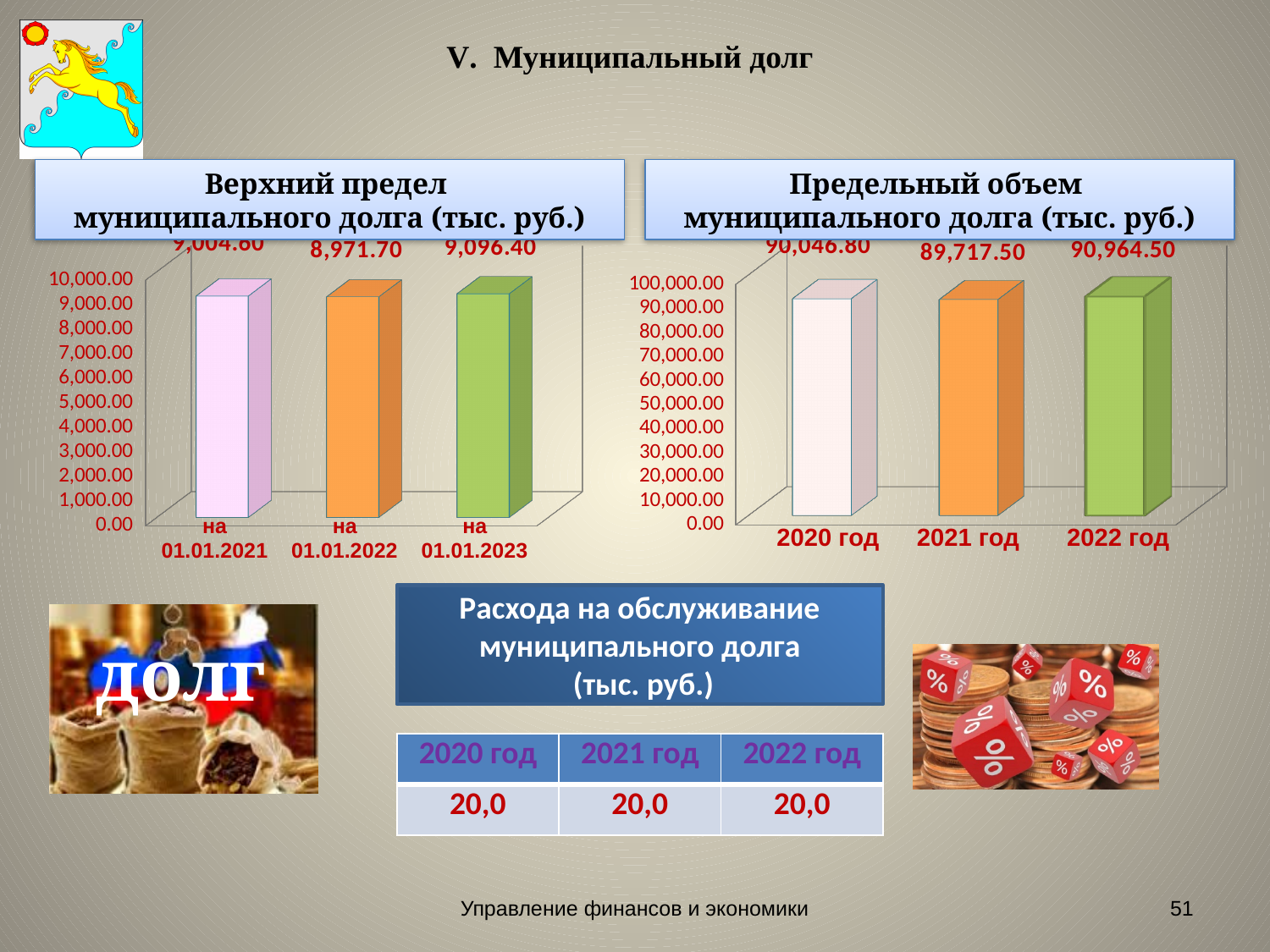
In the chart 'Предельный объем муниципального долга (тыс. руб.)', which is larger: the value for 2021 год or 2022 год? 2022 год In the chart 'Верхний предел муниципального долга (тыс. руб.)', is the value for на 01.01.2022 greater or less than 8,000.00? greater In the chart 'Верхний предел муниципального долга (тыс. руб.)', what is the value for на 01.01.2023? 9,096.40 How many categories are shown in the chart 'Предельный объем муниципального долга (тыс. руб.)'? 3 In the chart 'Предельный объем муниципального долга (тыс. руб.)', what is the value for 2021 год? 89,717.50 In the chart 'Предельный объем муниципального долга (тыс. руб.)', what is the value for 2022 год? 90,964.50 In the chart 'Верхний предел муниципального долга (тыс. руб.)', what is the difference between the values for на 01.01.2023 and на 01.01.2022? 124.70 In the chart 'Предельный объем муниципального долга (тыс. руб.)', what is the difference between the values for 2022 год and 2021 год? 1,247.00 What kind of chart is 'Верхний предел муниципального долга (тыс. руб.)'? bar chart In the chart 'Предельный объем муниципального долга (тыс. руб.)', which year has the highest value? 2022 год In the chart 'Верхний предел муниципального долга (тыс. руб.)', which category has the lowest value? на 01.01.2022 In the chart 'Верхний предел муниципального долга (тыс. руб.)', what is the value for на 01.01.2022? 8,971.70